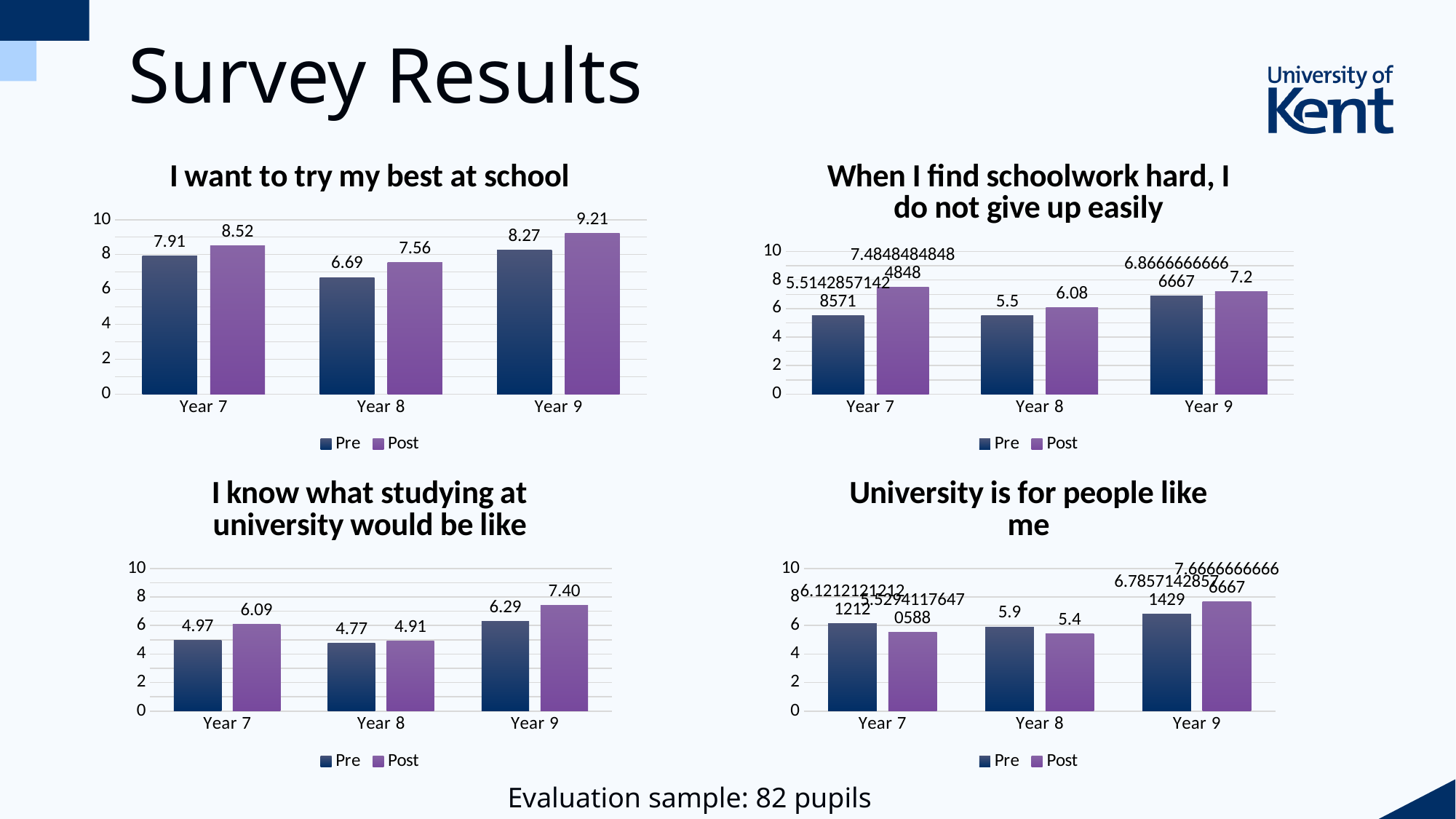
In the chart 'I want to try my best at school', what is the difference between the Post and Pre values for Year 7? 0.61 In the chart 'University is for people like me', is the Pre value for Year 8 larger or smaller than the Post value for Year 8? larger In the chart 'When I find schoolwork hard, I do not give up easily', which year has the highest Post value? Year 7 In the chart 'When I find schoolwork hard, I do not give up easily', what is the Post value for Year 8? 6.08 What type of chart is 'University is for people like me'? bar chart How many series does the legend list in the chart 'I want to try my best at school'? 2 In the chart 'I want to try my best at school', what is the Pre value for Year 8? 6.69 In the chart 'I know what studying at university would be like', what is the difference between the Post and Pre values for Year 8? 0.14 In the chart 'I know what studying at university would be like', which year has the lowest Pre value? Year 8 In the chart 'I want to try my best at school', what is the Post value for Year 9? 9.21 In the chart 'University is for people like me', what is the Post value for Year 8? 5.4 In the chart 'I know what studying at university would be like', what is the Post value for Year 9? 7.40